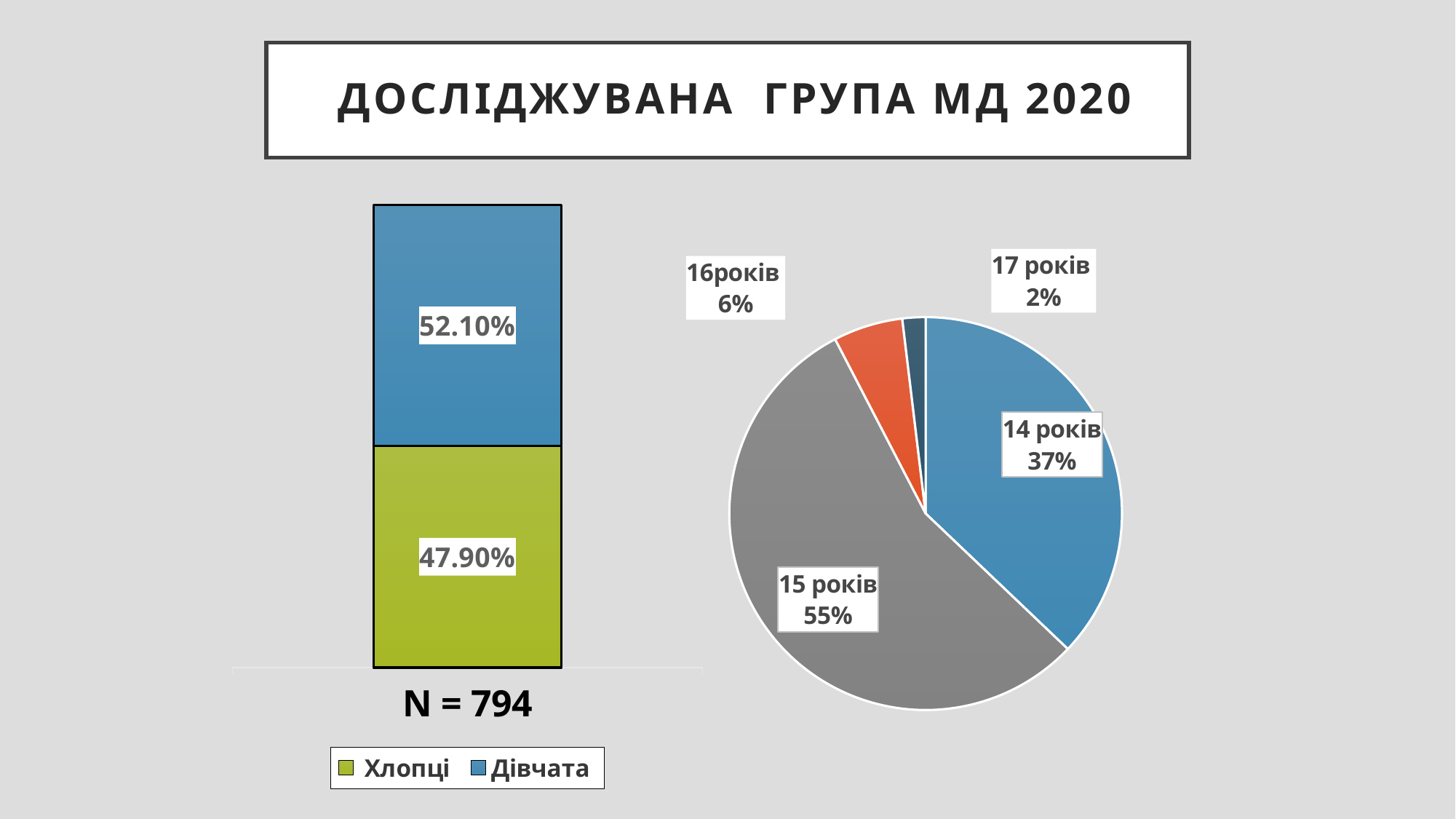
In the pie chart on the right, what share does 14 років have? 37% How many slices does the pie chart on the right have? 4 In the stacked bar chart on the left, which series has the larger share, Хлопці or Дівчата? Дівчата What type of chart is shown on the right of the slide? Pie chart In the pie chart on the right, what share does 15 років have? 55% How many series does the legend of the stacked bar chart on the left list? 2 What type of chart is shown on the left of the slide? Bar chart In the stacked bar chart on the left, what is the value for Дівчата? 52.10% In the pie chart on the right, which age group has the smallest slice? 17 років In the stacked bar chart on the left, what is the difference between the Дівчата and Хлопці values? 4.20% In the pie chart on the right, which age group has the largest slice? 15 років In the stacked bar chart on the left, what is the value for Хлопці? 47.90%